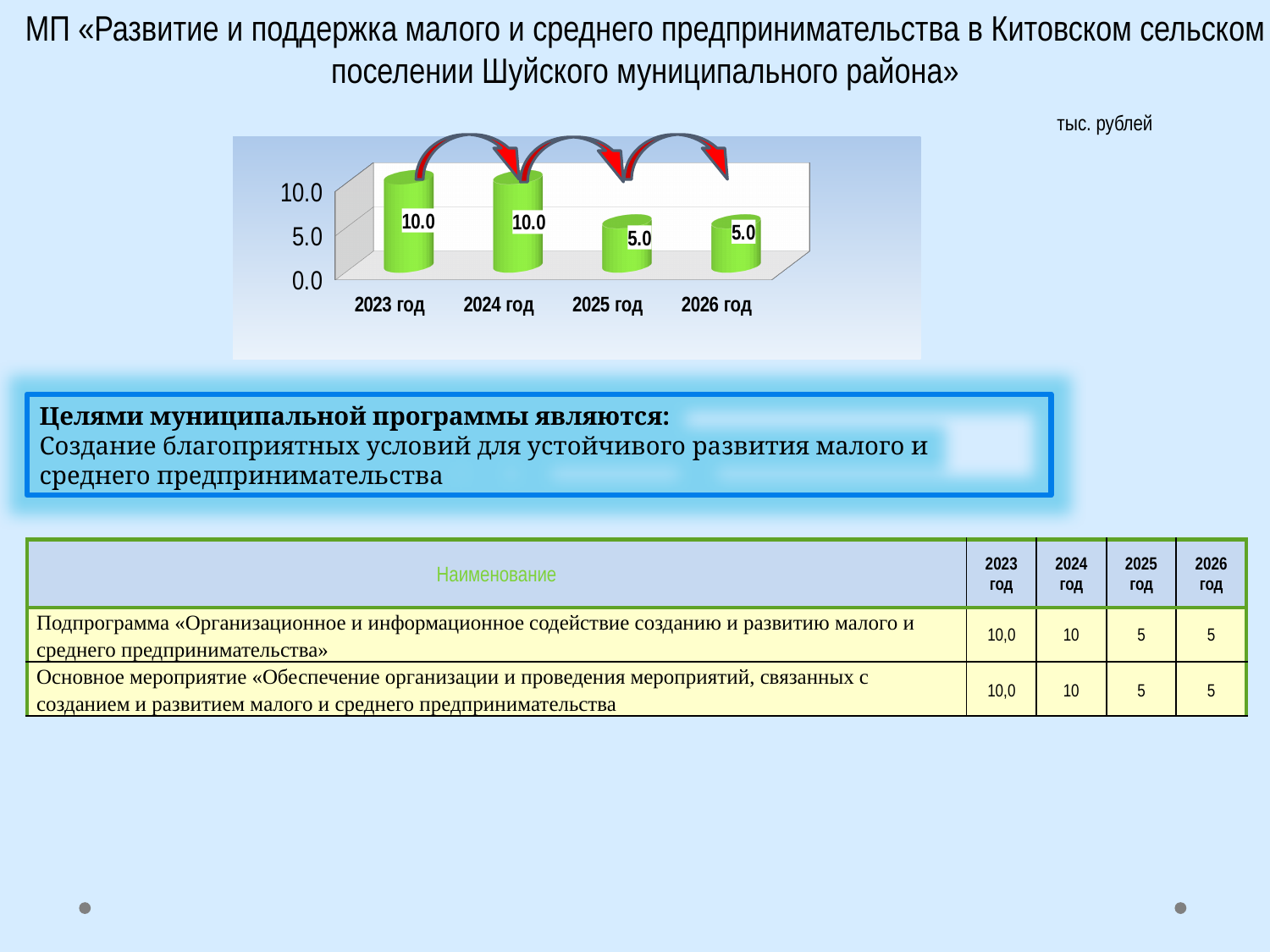
What is the difference between the values for 2024 год and 2025 год? 5.0 Is the value for 2025 год greater or less than 10.0? less Do the values rise or fall from 2023 год to 2026 год? fall What kind of chart is shown on the slide? bar chart What is the value for 2023 год on the chart? 10.0 How many categories are shown on the x axis of the chart? 4 What is the value for 2025 год on the chart? 5.0 What is the value for 2024 год on the chart? 10.0 Which is larger, the value for 2023 год or the value for 2026 год? 2023 год What unit is indicated for the chart values on the slide? тыс. рублей What is the value for 2026 год on the chart? 5.0 What colour are the bars in the chart? green